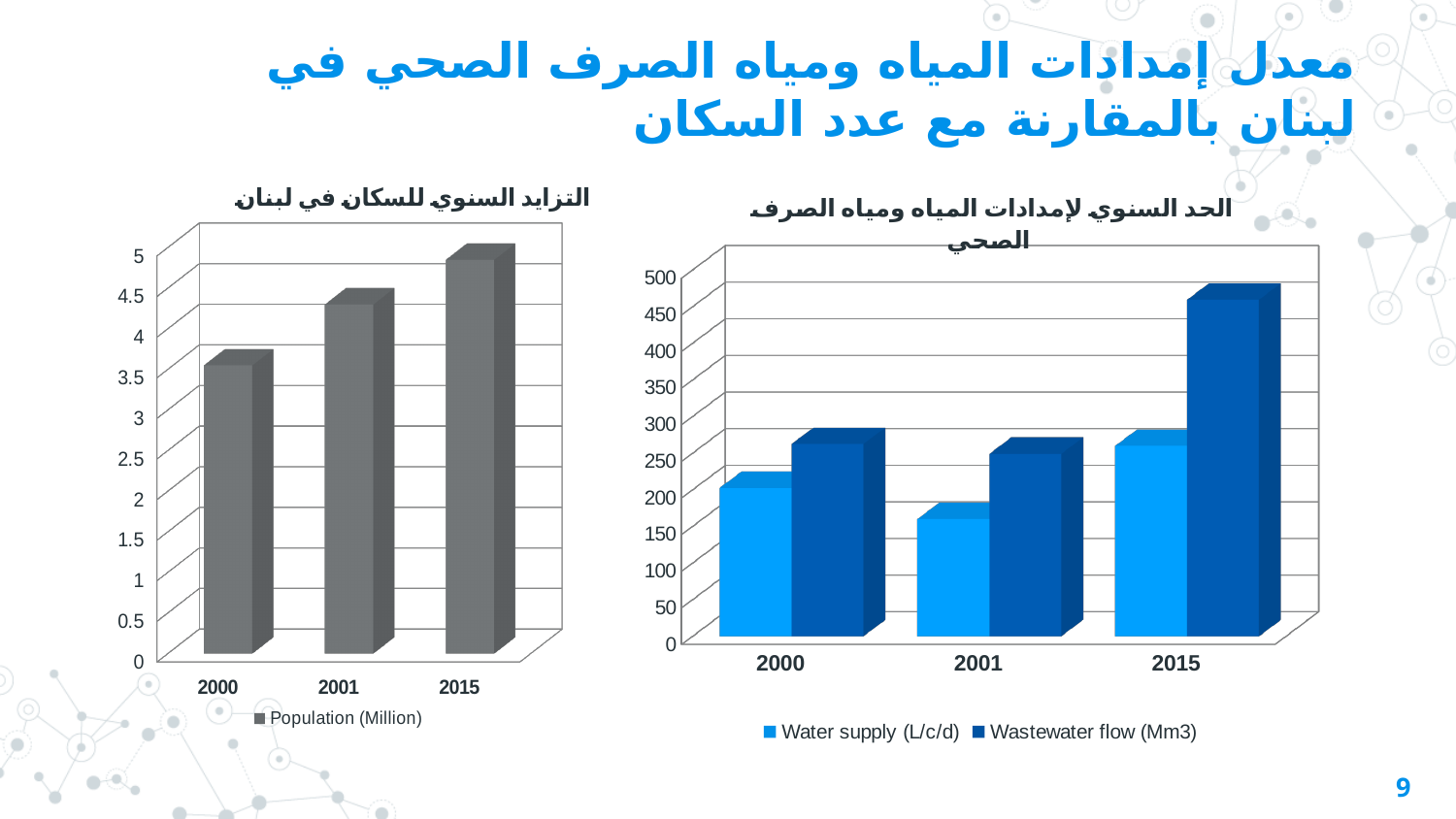
On the left chart (population), which year has the highest bar? 2015 On the right chart (water supply and wastewater), is the Wastewater flow value for 2015 greater or less than 400? greater On the left chart (population), which year has the lowest bar? 2000 On the left chart (population), is the value for 2015 greater or less than 4.5? greater On the right chart (water supply and wastewater), is the Water supply value for 2001 greater or less than 200? less On the right chart (water supply and wastewater), which year has the highest Wastewater flow? 2015 On the right chart (water supply and wastewater), how many series does the legend list? 2 On the left chart (population), what series does the legend list? Population (Million) On the right chart (water supply and wastewater), in 2001, which is larger: Water supply or Wastewater flow? Wastewater flow On the right chart (water supply and wastewater), how many years are shown on the x axis? 3 On the left chart (population), do the values rise or fall from 2000 to 2015? rise